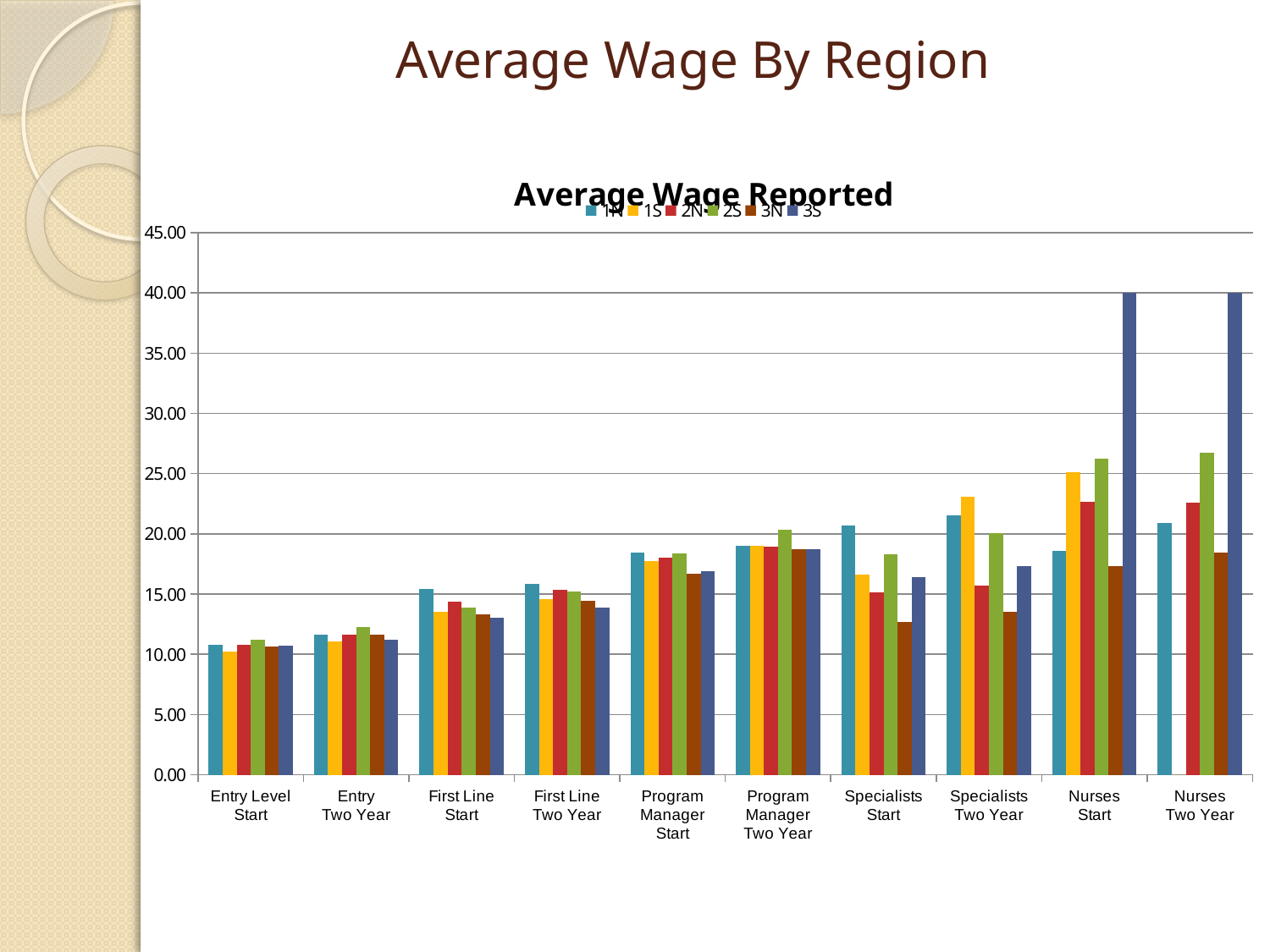
What is the title of the chart? Average Wage Reported How many series does the chart's legend list? 6 How many categories are shown along the x axis of the chart? 10 Is the value for 1N at Entry Level Start greater or less than 15? less Which series has the highest bar for Nurses Start? 3S Is the value for 2S at Nurses Start greater or less than 20? greater Do the 2S values generally rise or fall moving from Entry Level Start to Nurses Two Year along the x axis? rise Is the value for 3N at Specialists Two Year greater or less than 15? less For Nurses Start, which is larger: the 1S bar or the 1N bar? 1S Which series has the lowest bar for Specialists Two Year? 3N What kind of chart is shown on the slide? Bar chart